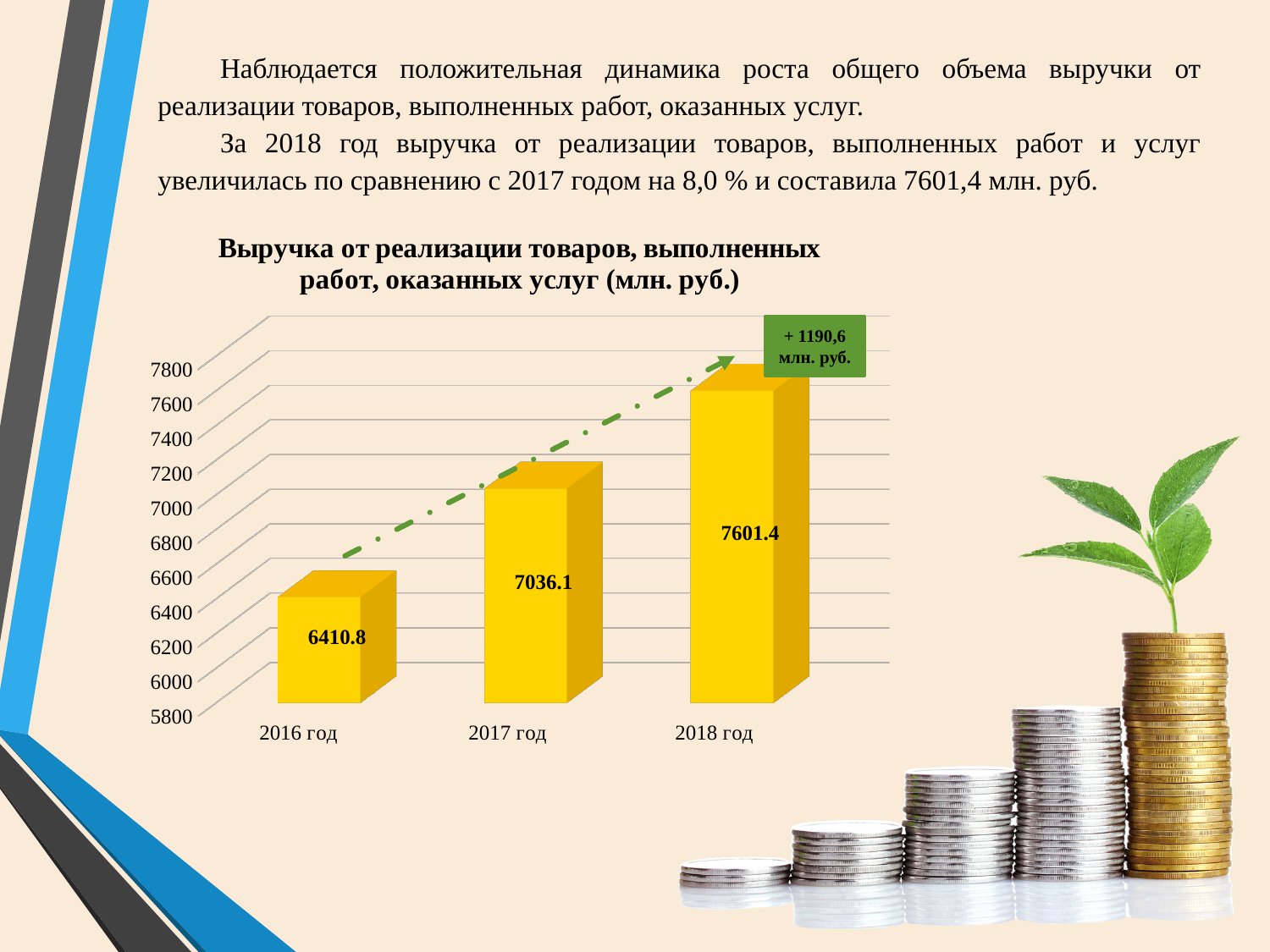
What is the difference between the values for 2017 год and 2016 год? 625.3 What is the difference between the values for 2018 год and 2016 год? 1190.6 Which year has the lowest value? 2016 год What is the value for 2016 год? 6410.8 Which year has the highest value? 2018 год What kind of chart is shown on the slide? bar chart Do the values rise or fall from 2016 год to 2018 год? rise How many years are shown on the chart? 3 What is the value for 2018 год? 7601.4 Which is larger, the value for 2017 год or the value for 2018 год? 2018 год Is the value for 2017 год greater or less than 7000? greater What is the value for 2017 год? 7036.1